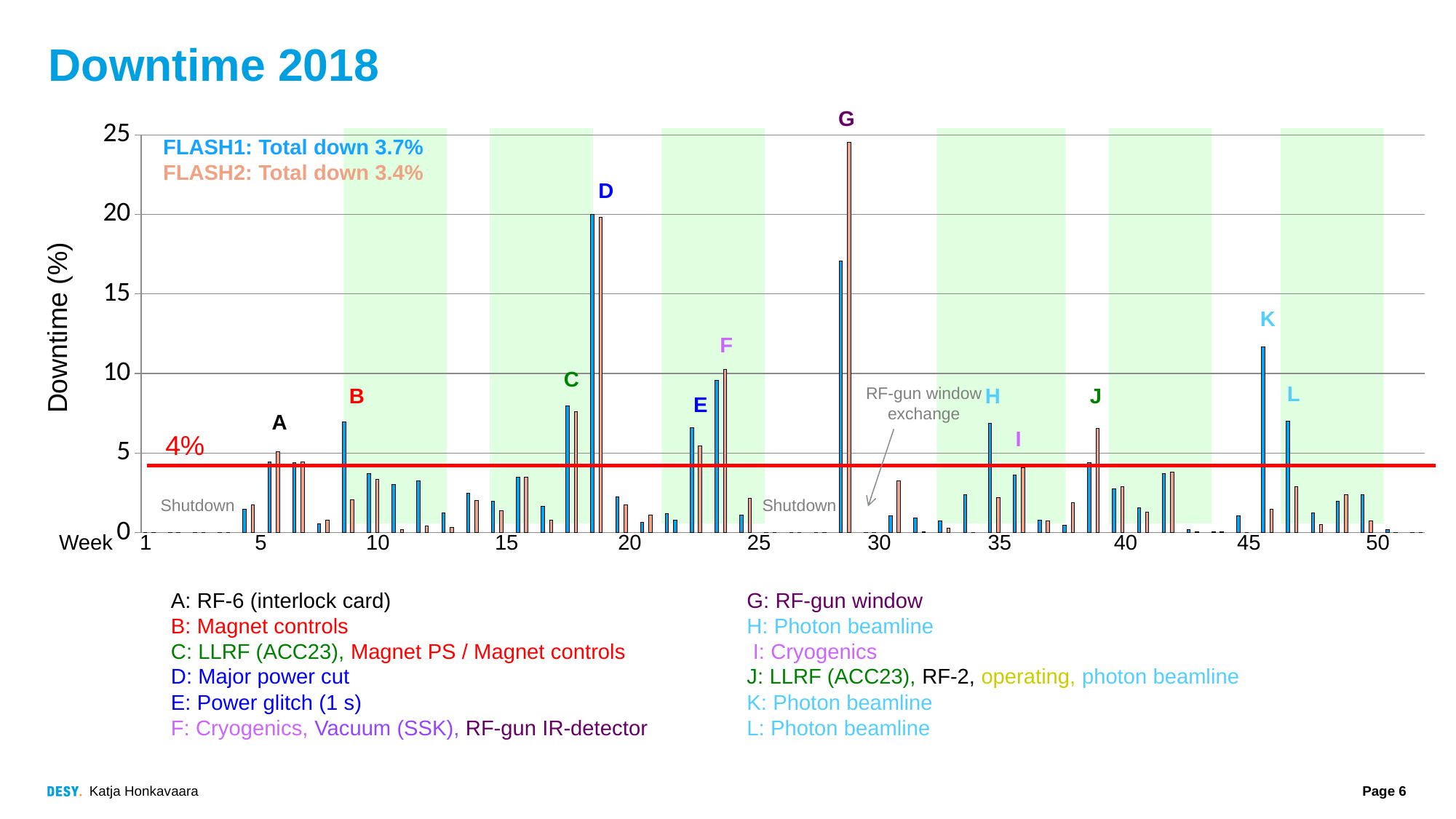
What is the label of the y axis? Downtime (%) What is the total downtime for FLASH2 stated on the chart? 3.4% At event K (around week 46), which series has the larger downtime, FLASH1 or FLASH2? FLASH1 Which labelled event has the highest downtime bar in the chart? G Is the FLASH2 downtime at event G (around week 29) greater or less than 20? greater What is the total downtime for FLASH1 stated on the chart? 3.7% At event G (around week 29), which series has the larger downtime, FLASH1 or FLASH2? FLASH2 How many data series (FLASH1 and FLASH2) does the chart show? 2 What downtime level does the red horizontal line mark? 4% What kind of chart is shown on the slide? bar chart Is the FLASH1 downtime at event K (around week 46) greater or less than 10? greater Is the FLASH1 downtime at event C (around week 18) greater or less than 10? less